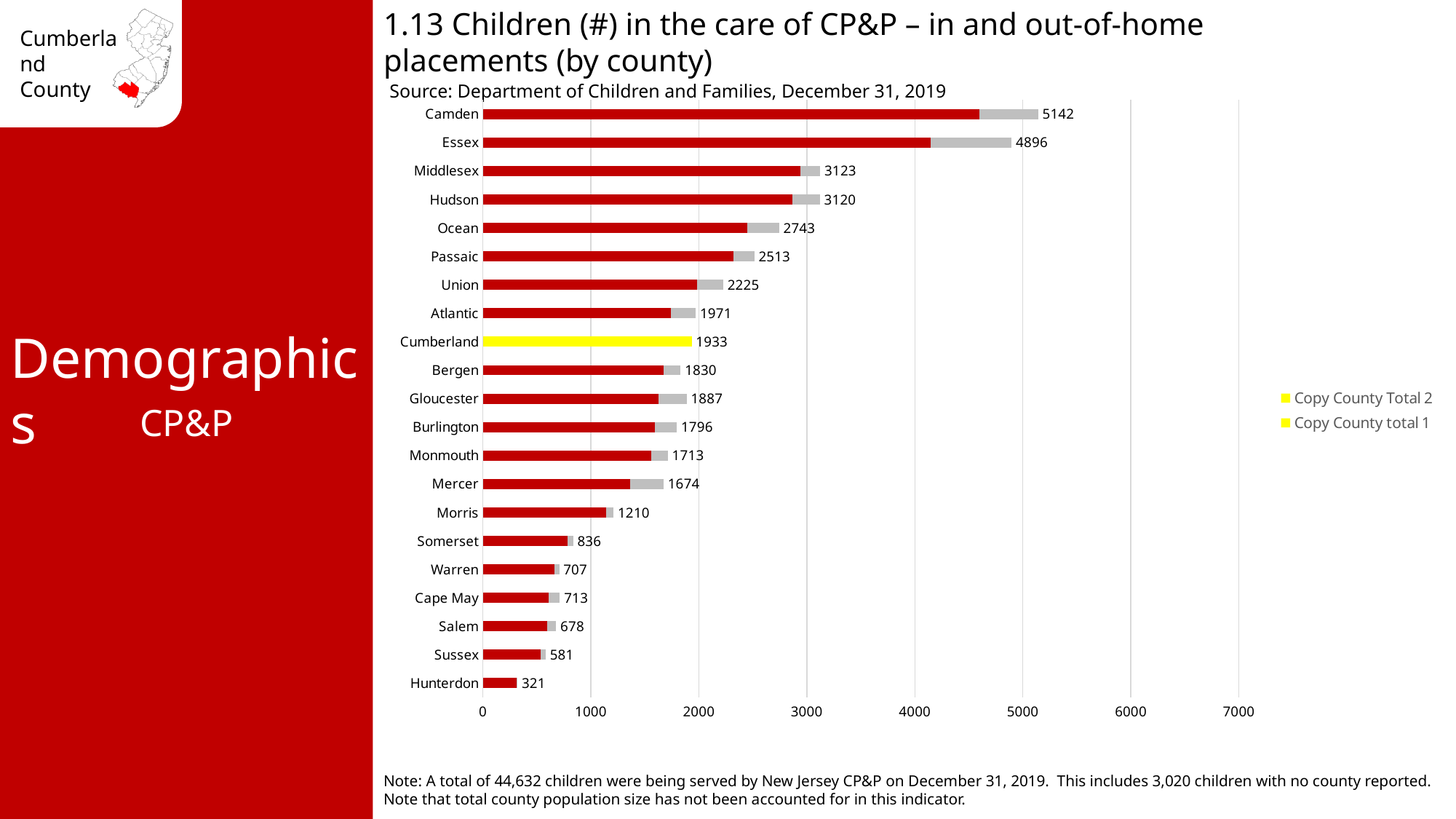
What is the total number of children in the care of CP&P for Hunterdon? 321 How many counties are shown in the chart? 21 What is the total number of children in the care of CP&P for Cumberland? 1933 Is the total for Ocean greater or less than 3000? less What is the difference between the totals for Camden and Essex? 246 How many series does the legend list? 2 Which county has the highest total number of children in the care of CP&P? Camden Which county's bar is highlighted in yellow? Cumberland Which county has the lowest total number of children in the care of CP&P? Hunterdon What is the total number of children in the care of CP&P for Camden? 5142 Which county has a larger total, Atlantic or Cumberland? Atlantic What kind of chart is shown on the slide? Bar chart